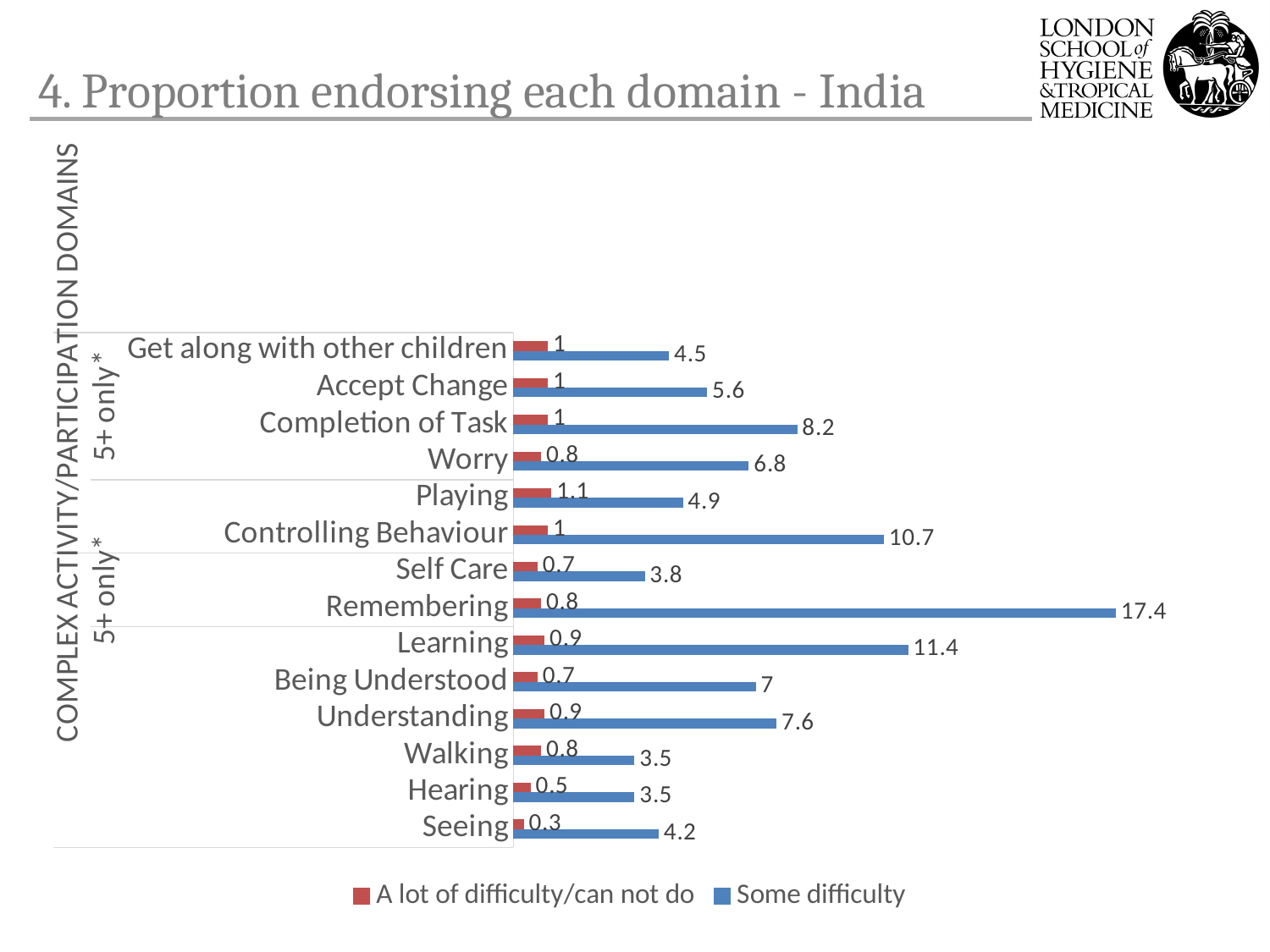
What is the title of the slide's chart? 4. Proportion endorsing each domain - India Which domain has the lowest 'A lot of difficulty/can not do' value? Seeing How many domains are shown in the chart? 14 What is the 'Some difficulty' value for Controlling Behaviour? 10.7 What is the 'A lot of difficulty/can not do' value for Seeing? 0.3 What is the 'Some difficulty' value for Remembering? 17.4 How many series does the legend list? 2 Which domain has the highest 'A lot of difficulty/can not do' value? Playing Which has a larger 'Some difficulty' value, Completion of Task or Worry? Completion of Task What type of chart is shown on the slide? Bar chart What is the difference between the 'Some difficulty' values for Learning and Self Care? 7.6 Which domain has the highest 'Some difficulty' value? Remembering